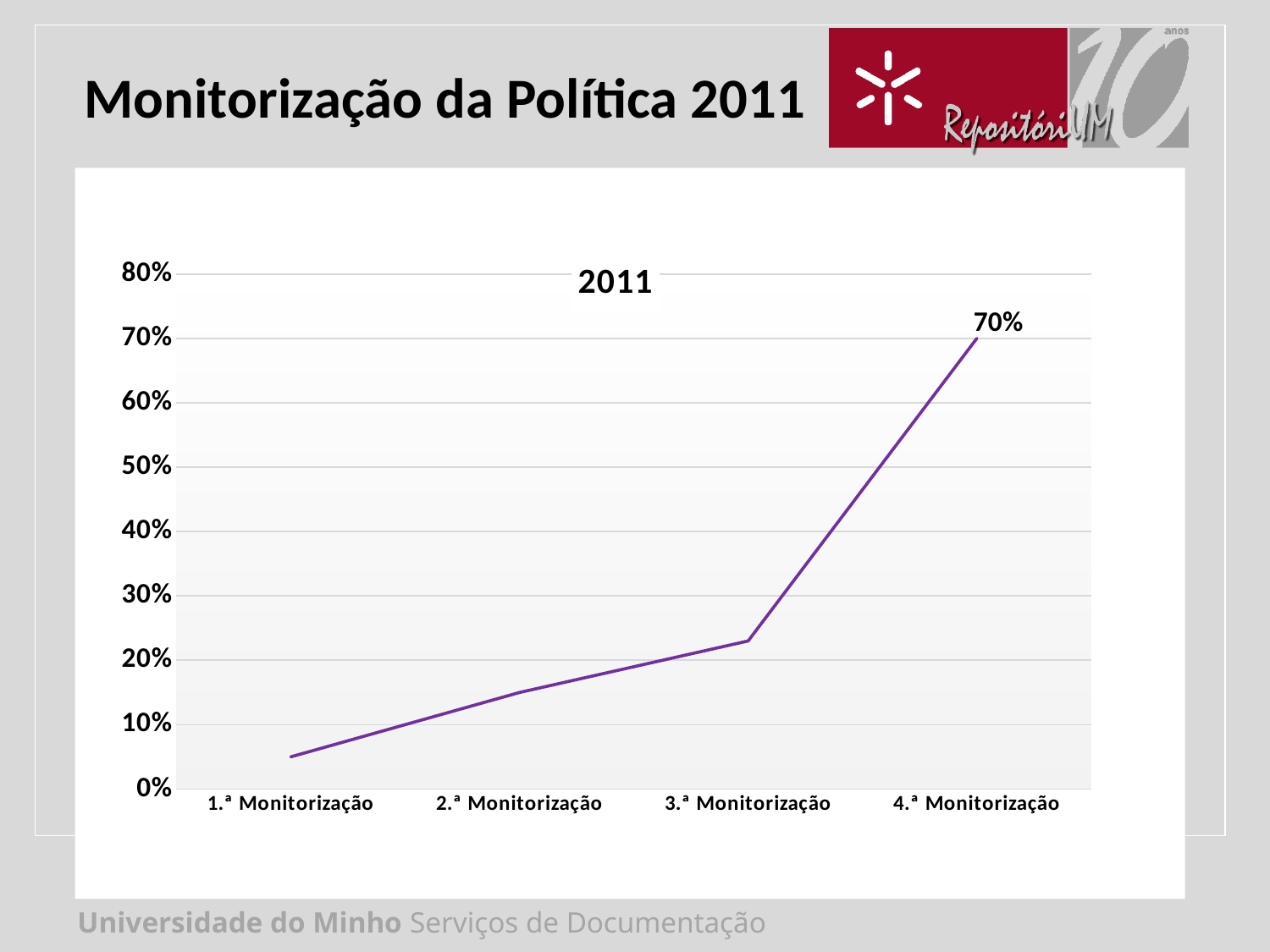
What is the value for 4.ª Monitorização? 70% Is the value for 2.ª Monitorização greater or less than 10%? greater Is the value for 3.ª Monitorização greater or less than 30%? less How many categories are plotted on the x axis? 4 Do the values rise or fall from 1.ª Monitorização to 4.ª Monitorização? rise What kind of chart is shown on the slide? line chart Which category has the highest value? 4.ª Monitorização Which category has the lowest value? 1.ª Monitorização Which is larger, the value for 2.ª Monitorização or 3.ª Monitorização? 3.ª Monitorização Is the value for 1.ª Monitorização greater or less than 10%? less What is the title of the chart? 2011